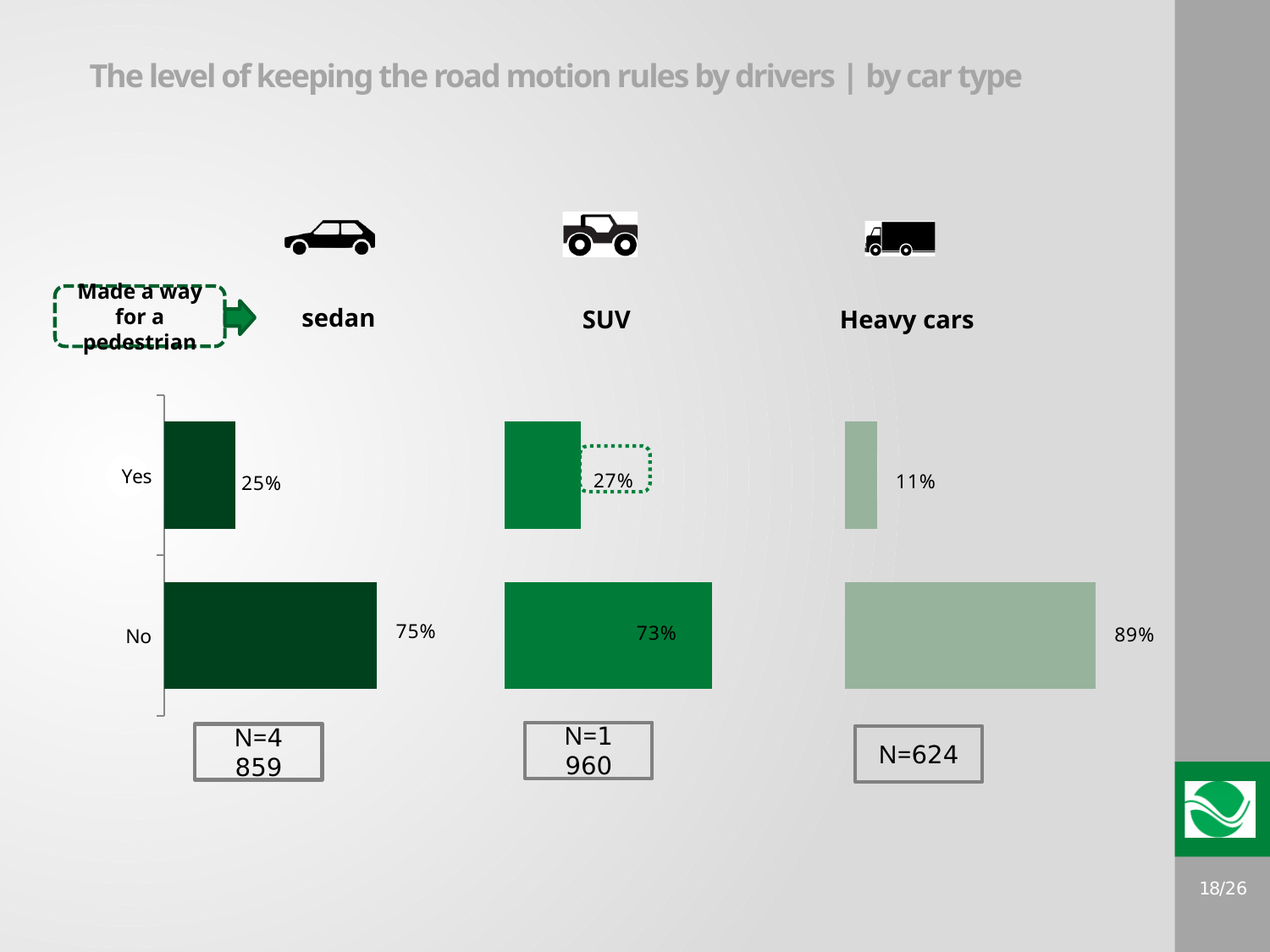
In the Heavy cars chart, what is the value for No? 89% In the Heavy cars chart, what is the value for Yes? 11% What kind of chart is used for the SUV data? bar chart In the SUV chart, what is the value for Yes? 27% In the sedan chart, what is the difference between the No and Yes values? 50% Across the three charts, which car type has the lowest share of drivers answering Yes? Heavy cars In the sedan chart, what percentage of drivers made a way for a pedestrian (Yes)? 25% Across the three charts, which car type has the highest share of drivers answering Yes? SUV In the SUV chart, what is the value for No? 73% What is the sample size (N) shown under the Heavy cars chart? N=624 How many categories are shown in the sedan chart? 2 Is the Yes value larger for the sedan chart or the Heavy cars chart? sedan